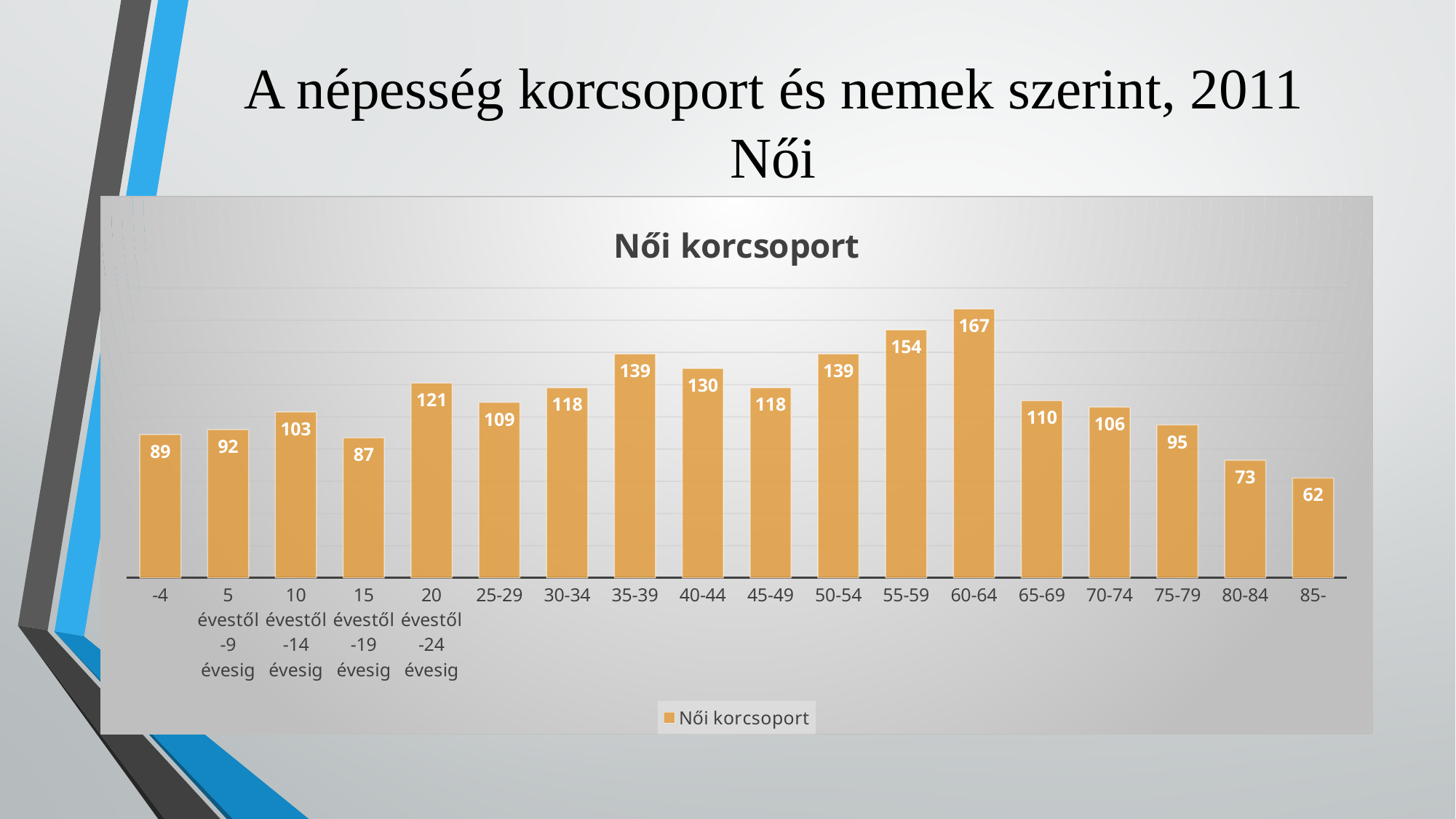
What is the difference between the values for the 60-64 and 55-59 age groups? 13 What is the difference between the values for the 80-84 and 85- age groups? 11 Which age group has the highest value? 60-64 How many age groups are shown on the chart? 18 Which is larger, the value for 40-44 or the value for 45-49? 40-44 What is the value for the 25-29 age group? 109 What is the value for the 85- age group? 62 How many series does the legend list? 1 Which age group has the lowest value? 85- What kind of chart is shown on the slide? Bar chart What is the value for the 60-64 age group? 167 What is the title of the chart? Női korcsoport